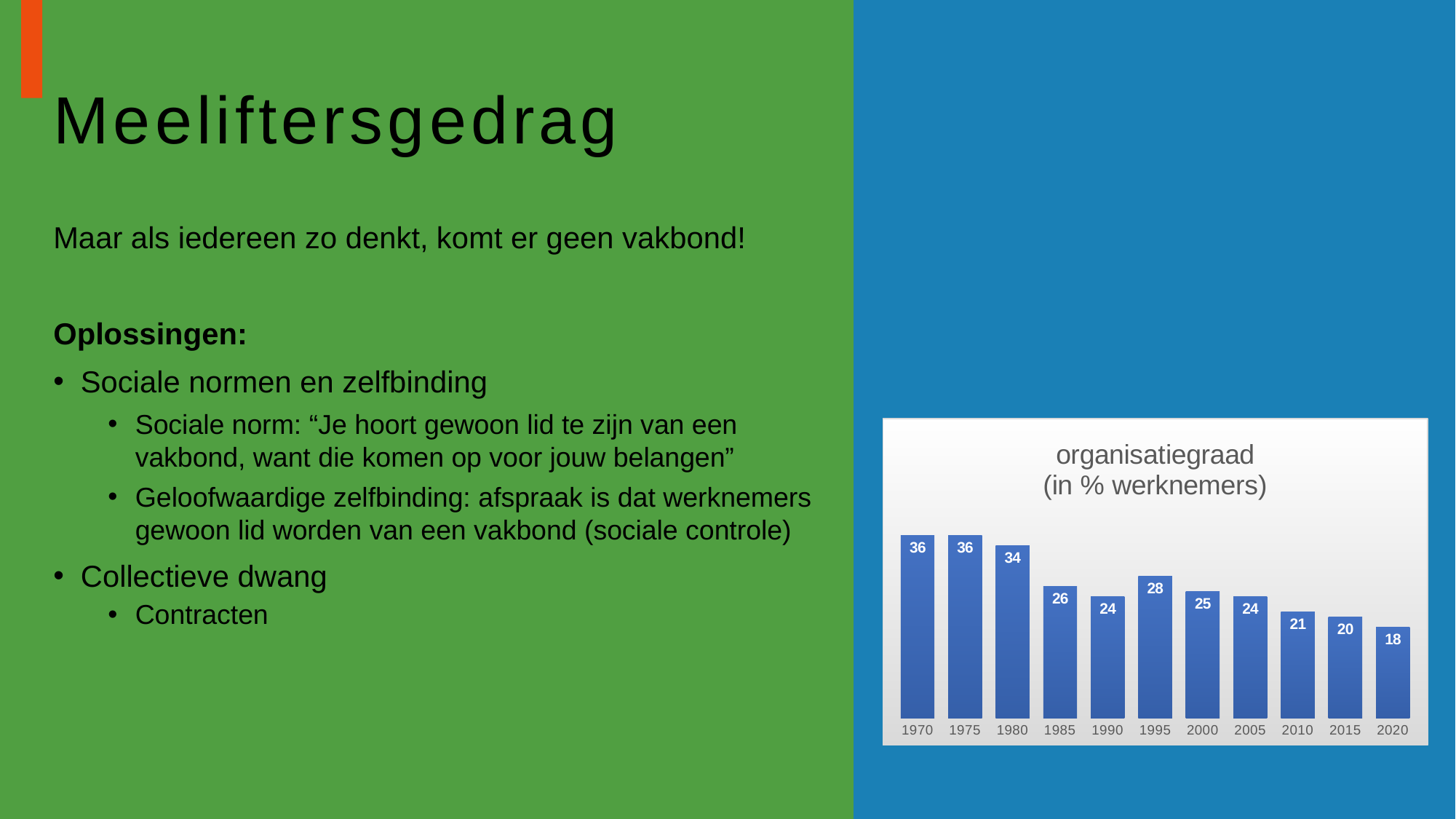
What is the value for 1995? 28 Do the values generally rise or fall from 1970 to 2020? fall What is the difference between the values for 1970 and 2020? 18 Which year has the lowest value? 2020 What is the title of the chart? organisatiegraad (in % werknemers) What is the value for 2020? 18 What kind of chart is this? bar chart What is the difference between the values for 1985 and 1990? 2 Which two years share the highest value? 1970 and 1975 Which is larger, the value for 1995 or the value for 2005? 1995 How many years are shown on the x axis? 11 What is the value for 1980? 34